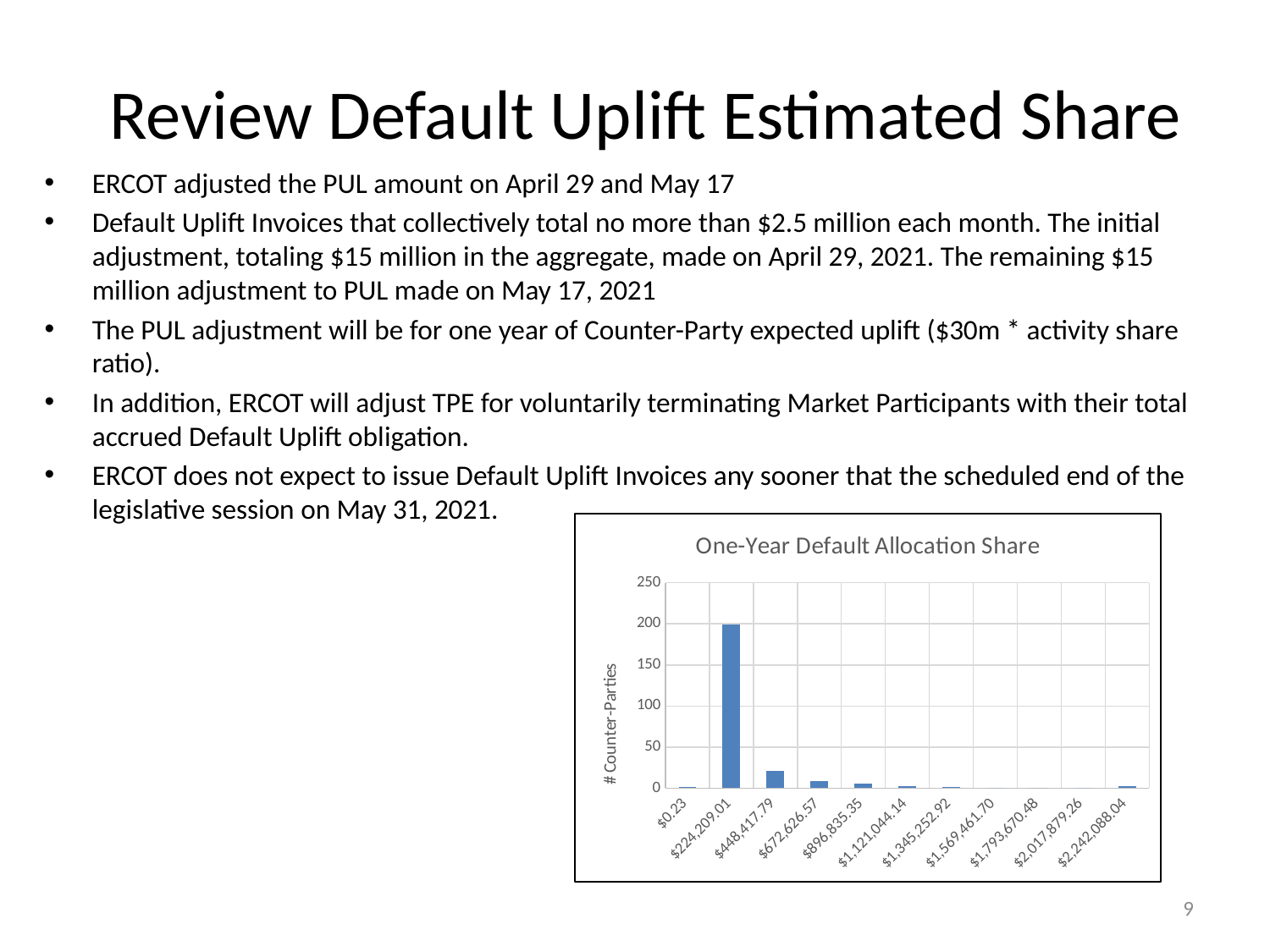
What is the title of the chart on the slide? One-Year Default Allocation Share How many categories are shown along the x axis of the chart? 11 Is the value for $672,626.57 greater or less than 50? less What kind of chart is shown on the slide? bar chart Which has more Counter-Parties, $224,209.01 or $448,417.79? $224,209.01 Which has more Counter-Parties, $448,417.79 or $672,626.57? $448,417.79 What is the label on the vertical axis of the chart? # Counter-Parties Is the value for $0.23 greater or less than 50? less Which category has the highest number of Counter-Parties? $224,209.01 Is the value for $448,417.79 greater or less than 50? less